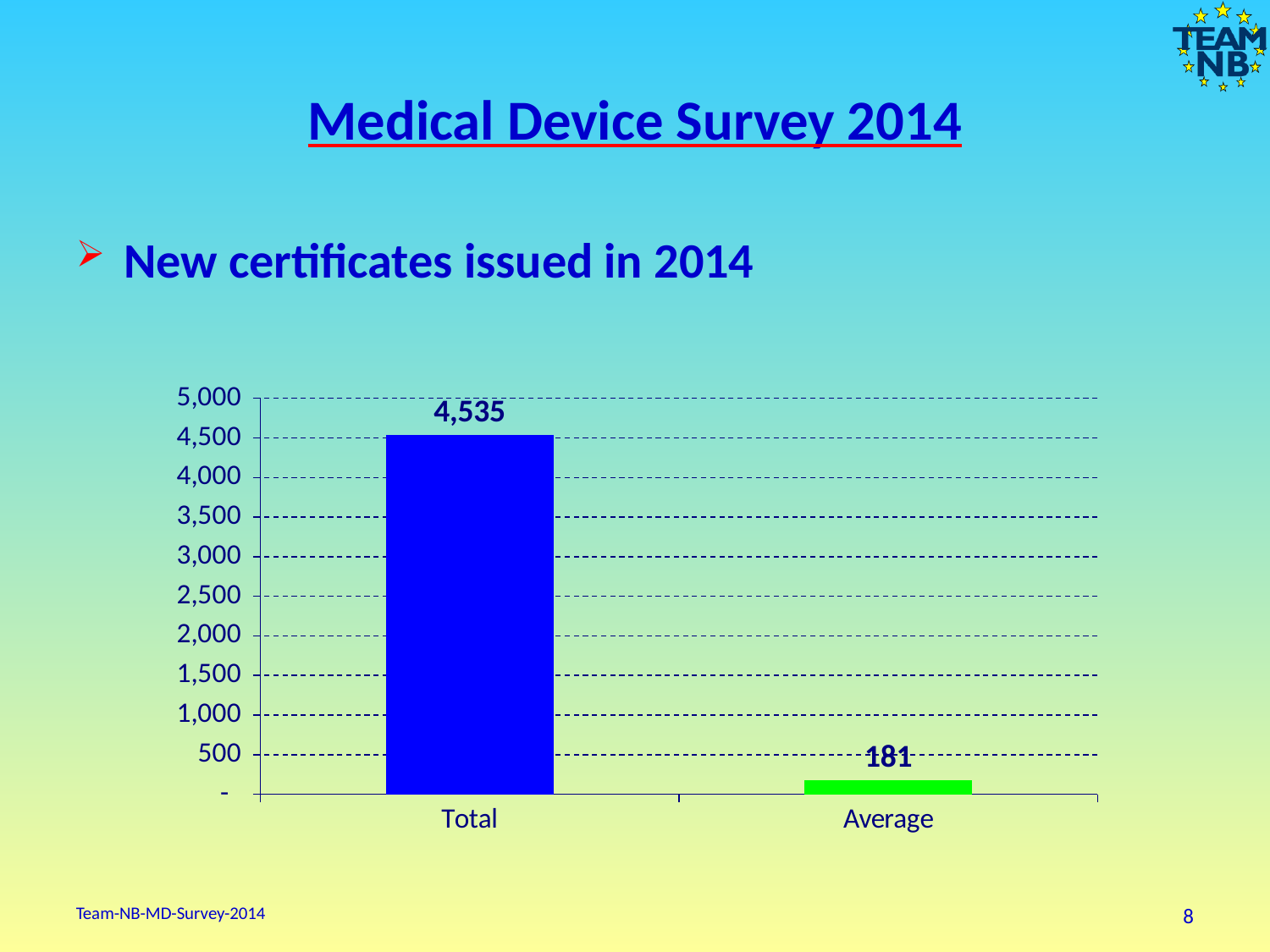
What is the highest value shown on the y axis? 5,000 Which category has the lowest value? Average Is the value for Total greater or less than 4,000? greater What kind of chart is shown on the slide? bar chart What is the value for Average? 181 Is the value for Average greater or less than 500? less Which category has the highest value? Total How many categories are shown on the x axis? 2 What is the value for Total? 4,535 Which is larger, the value for Total or the value for Average? Total What colour is the bar for Total? blue What is the difference between the Total and Average values? 4,354